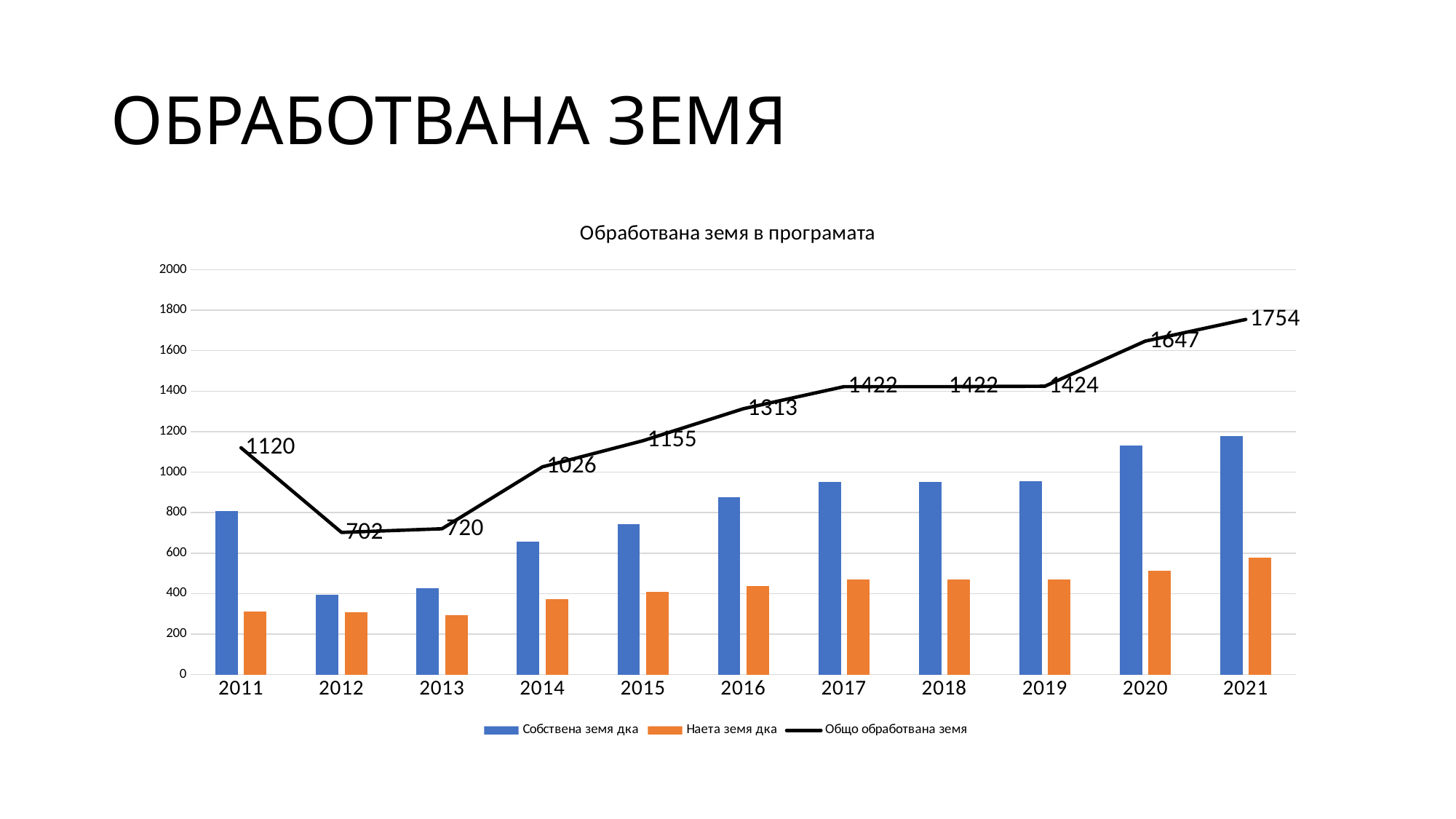
Which year has the larger Общо обработвана земя value, 2014 or 2015? 2015 What is the value of Общо обработвана земя for 2011? 1120 Is the value of Наета земя дка for 2013 greater or less than 400? less In which year is Общо обработвана земя highest? 2021 Is the value of Собствена земя дка for 2020 greater or less than 1000? greater What is the difference in Общо обработвана земя between 2021 and 2020? 107 How many years are shown on the x axis? 11 What is the difference in Общо обработвана земя between 2011 and 2012? 418 In which year is Общо обработвана земя lowest? 2012 How many series does the legend list? 3 What is the value of Общо обработвана земя for 2021? 1754 What is the value of Общо обработвана земя for 2016? 1313